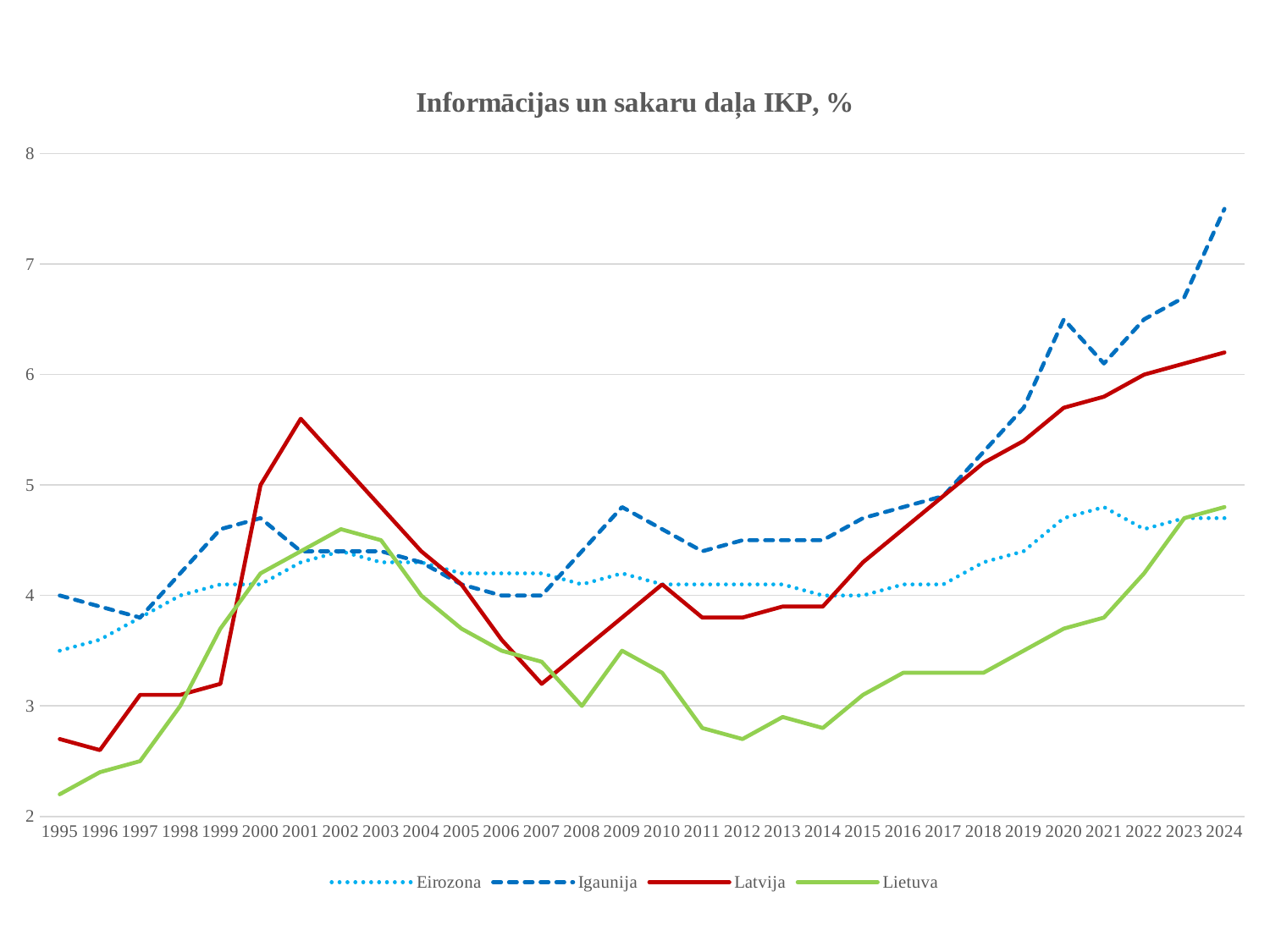
In 2001, which is larger: the value for Latvija or the value for Igaunija? Latvija Does the Igaunija series rise or fall from 2017 to 2024? rise Is the value for Latvija in 2001 greater or less than 5? greater How many series does the legend list? 4 What kind of chart is shown on the slide? line chart Is the value for Lietuva in 1995 greater or less than 3? less How many years are plotted along the x axis? 30 Which series has the lowest value in 2012? Lietuva What is the title of the chart? Informācijas un sakaru daļa IKP, % Which series has the highest value in 2024? Igaunija Is the value for Eirozona in 1995 greater or less than 4? less